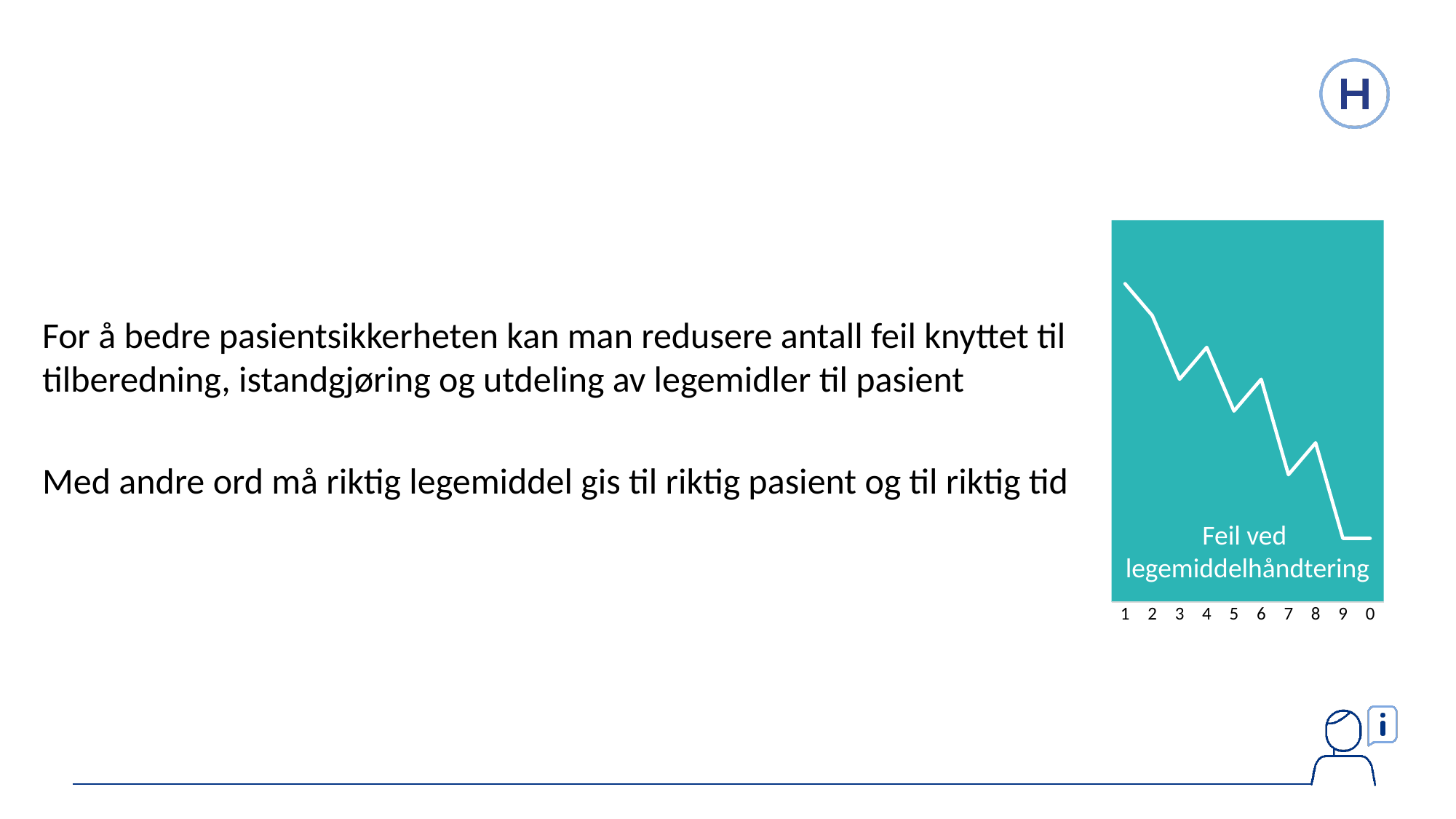
Do the values in the chart generally rise or fall along the x axis? fall Which is larger in the chart, the value at 4 or the value at 5? 4 Which is larger in the chart, the value at 3 or the value at 4? 4 What kind of chart is shown on the slide? line chart What colour is the background of the chart area? teal What is the title of the chart on the slide? Feil ved legemiddelhåndtering Which is larger in the chart, the value at 1 or the value at 0? 1 Which x-axis category has the highest value in the chart? 1 How many points are plotted along the x axis of the chart? 10